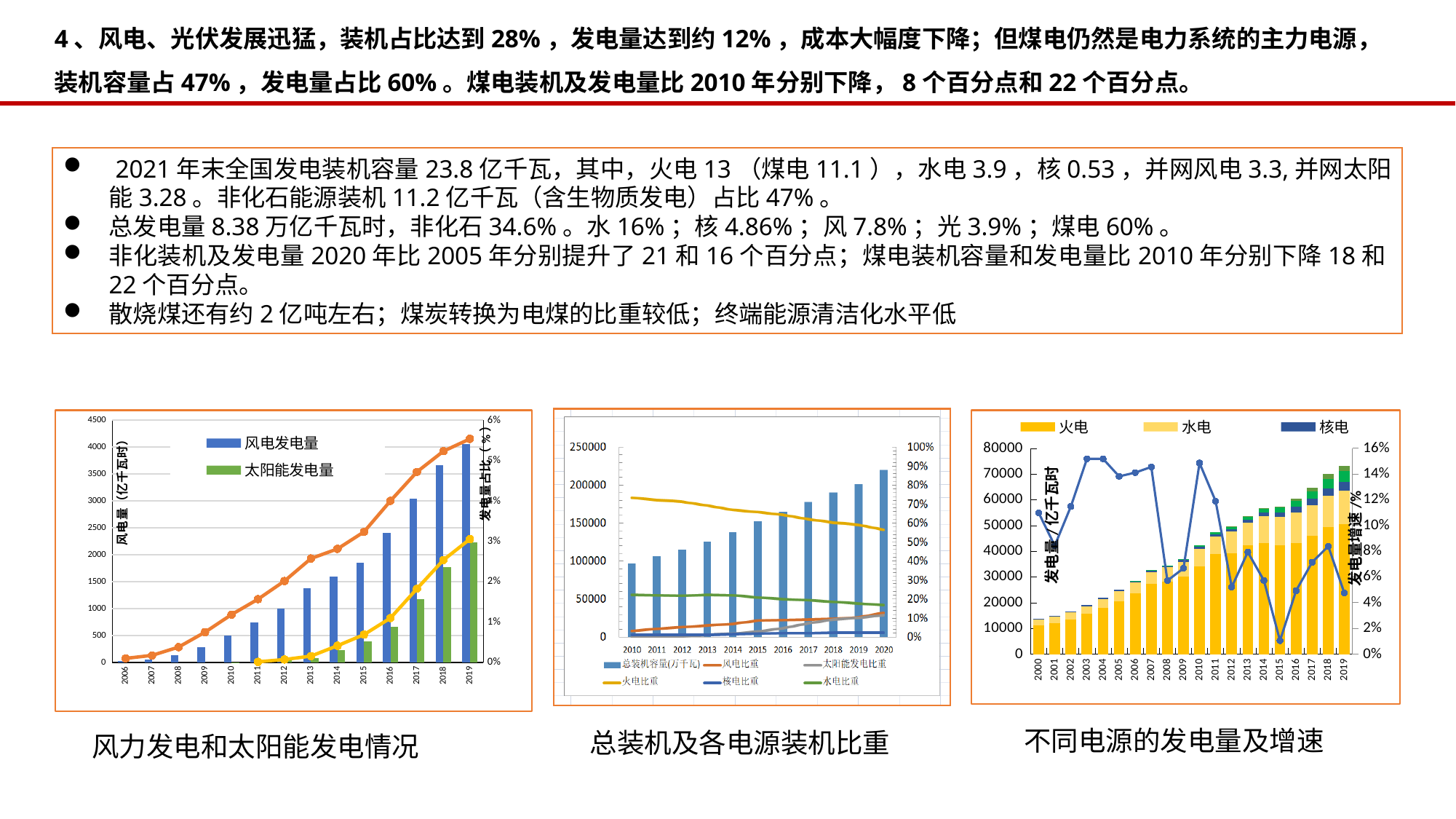
In the chart titled 风力发电和太阳能发电情况, which year has the highest 风电发电量 bar? 2019 In the chart titled 风力发电和太阳能发电情况, how many series does the legend list? 2 In the chart titled 风力发电和太阳能发电情况, is the 风电发电量 value for 2018 greater or less than 3500? greater In the chart titled 总装机及各电源装机比重, how many entries does the legend list? 6 In the chart titled 风力发电和太阳能发电情况, is the 太阳能发电量 value for 2019 greater or less than 2000? greater In the chart titled 不同电源的发电量及增速, in which year is the growth-rate line at its lowest point? 2015 In the chart titled 总装机及各电源装机比重, how many years are shown on the x axis? 11 In the chart titled 总装机及各电源装机比重, is the 总装机容量 value for 2020 greater or less than 200000? greater In the chart titled 风力发电和太阳能发电情况, how many years are shown on the x axis? 14 In the chart titled 总装机及各电源装机比重, does the 火电比重 line rise or fall from 2010 to 2020? fall In the chart titled 不同电源的发电量及增速, how many series does the legend list? 3